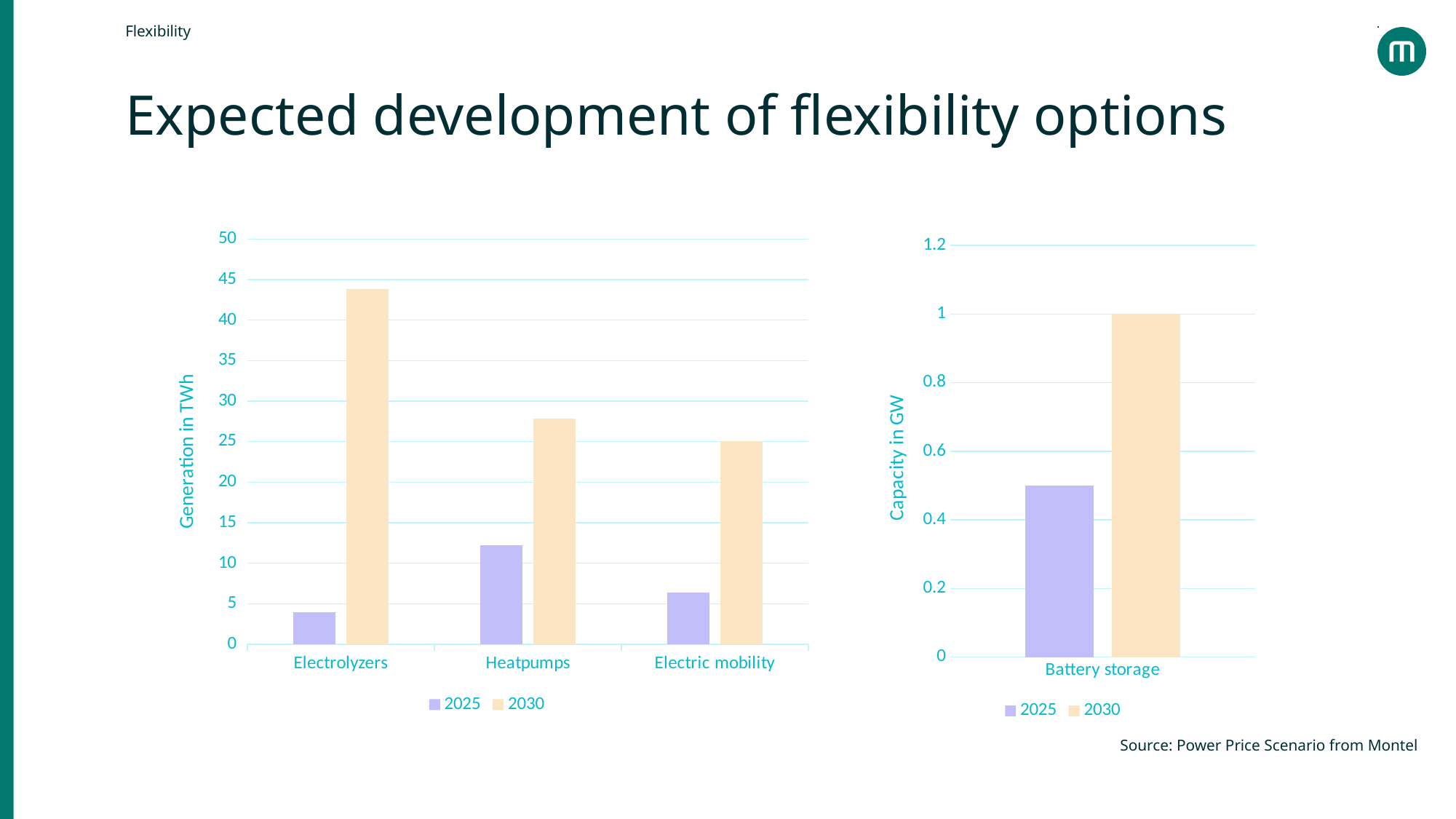
In the left chart (Generation in TWh), is the 2030 value for Electrolyzers greater or less than 40? greater What is the y-axis title of the right chart? Capacity in GW What kind of chart is the left chart (Generation in TWh)? bar chart How many categories are shown on the x axis of the left chart (Generation in TWh)? 3 In the left chart (Generation in TWh), is the 2025 value for Electric mobility greater or less than 10? less In the left chart (Generation in TWh), is the 2025 value for Heatpumps greater or less than 10? greater In the right chart (Capacity in GW), what is the 2030 value for Battery storage? 1 In the left chart (Generation in TWh), which category has the highest 2030 value? Electrolyzers How many series does the legend of the left chart (Generation in TWh) list? 2 In the left chart (Generation in TWh), which is larger for Heatpumps: the 2025 value or the 2030 value? 2030 In the left chart (Generation in TWh), which category has the lowest 2025 value? Electrolyzers